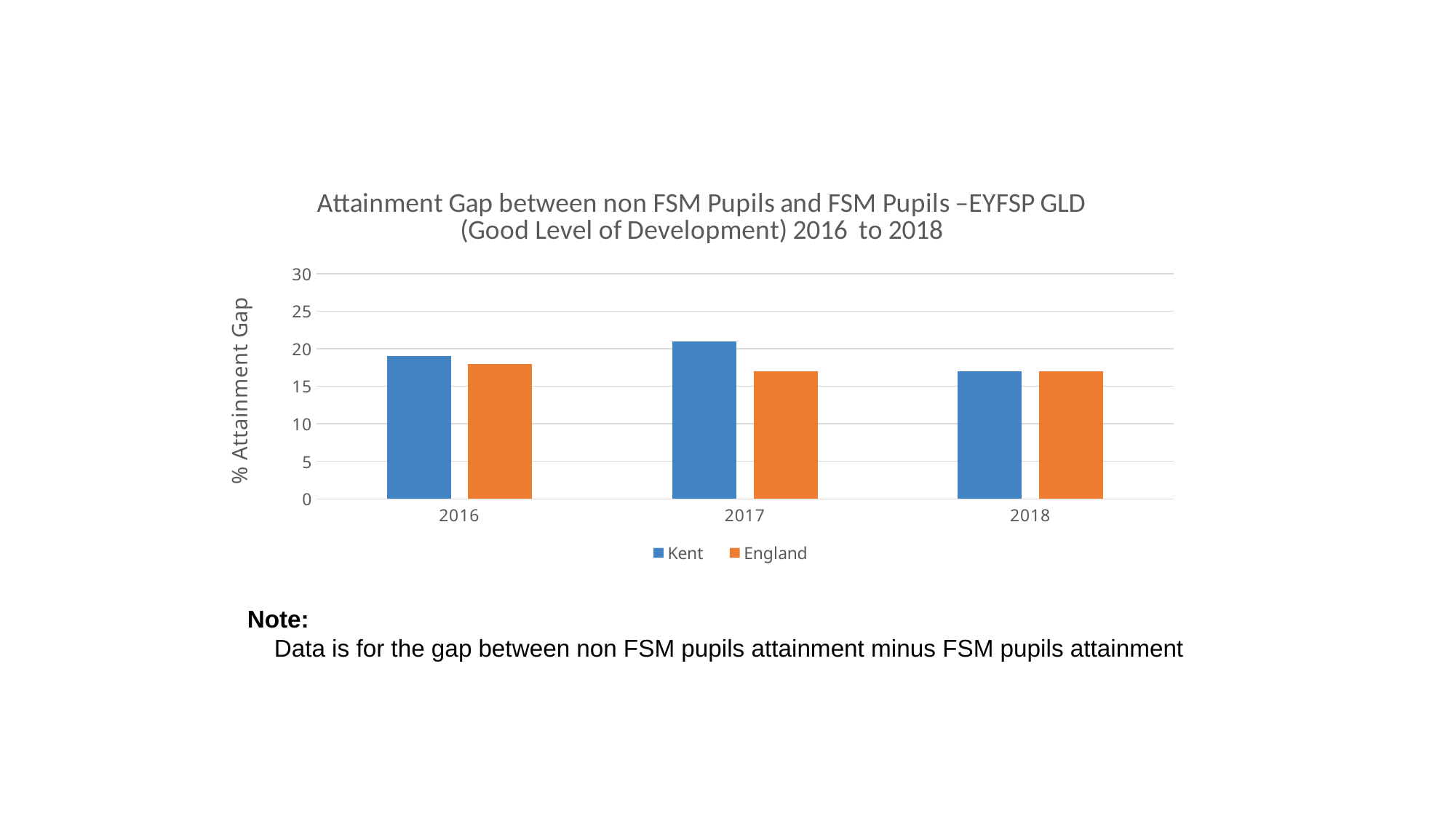
Is the value for Kent in 2017 greater or less than 20? greater Is the value for England in 2017 greater or less than 15? greater What is the label on the y axis? % Attainment Gap How many series does the legend list? 2 Does the Kent value rise or fall from 2017 to 2018? Fall Does the England value rise or fall from 2016 to 2017? Fall Is the value for England in 2018 greater or less than 20? less What kind of chart is shown on the slide? Bar chart Which year has the highest Kent attainment gap? 2017 How many years are shown on the x axis? 3 In 2017, which is larger, the Kent value or the England value? Kent